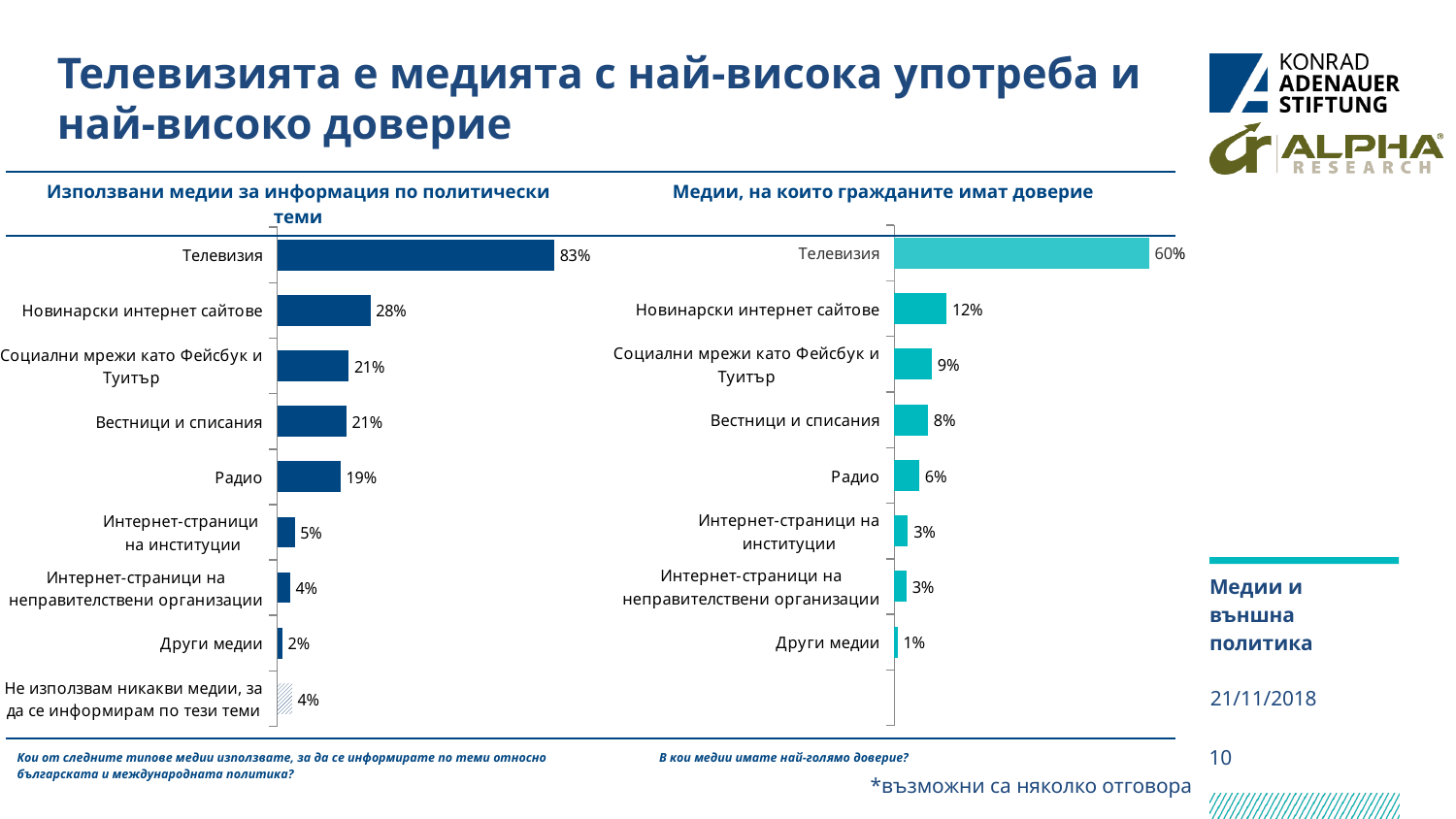
In the right chart 'Медии, на които гражданите имат доверие', what is the difference between the values for Телевизия and Радио? 54% What is the title of the left chart on the slide? Използвани медии за информация по политически теми What kind of chart is the right chart 'Медии, на които гражданите имат доверие'? Bar chart In the left chart 'Използвани медии за информация по политически теми', what is the value for Радио? 19% In the left chart 'Използвани медии за информация по политически теми', which category has the highest value? Телевизия In the left chart 'Използвани медии за информация по политически теми', what is the value for Телевизия? 83% In the right chart 'Медии, на които гражданите имат доверие', which is larger: the value for Вестници и списания or the value for Радио? Вестници и списания How many categories are shown in the right chart 'Медии, на които гражданите имат доверие'? 8 How many categories are shown in the left chart 'Използвани медии за информация по политически теми'? 9 In the right chart 'Медии, на които гражданите имат доверие', what is the value for Новинарски интернет сайтове? 12% In the left chart 'Използвани медии за информация по политически теми', what is the difference between the values for Телевизия and Новинарски интернет сайтове? 55% In the right chart 'Медии, на които гражданите имат доверие', which category has the lowest value? Други медии